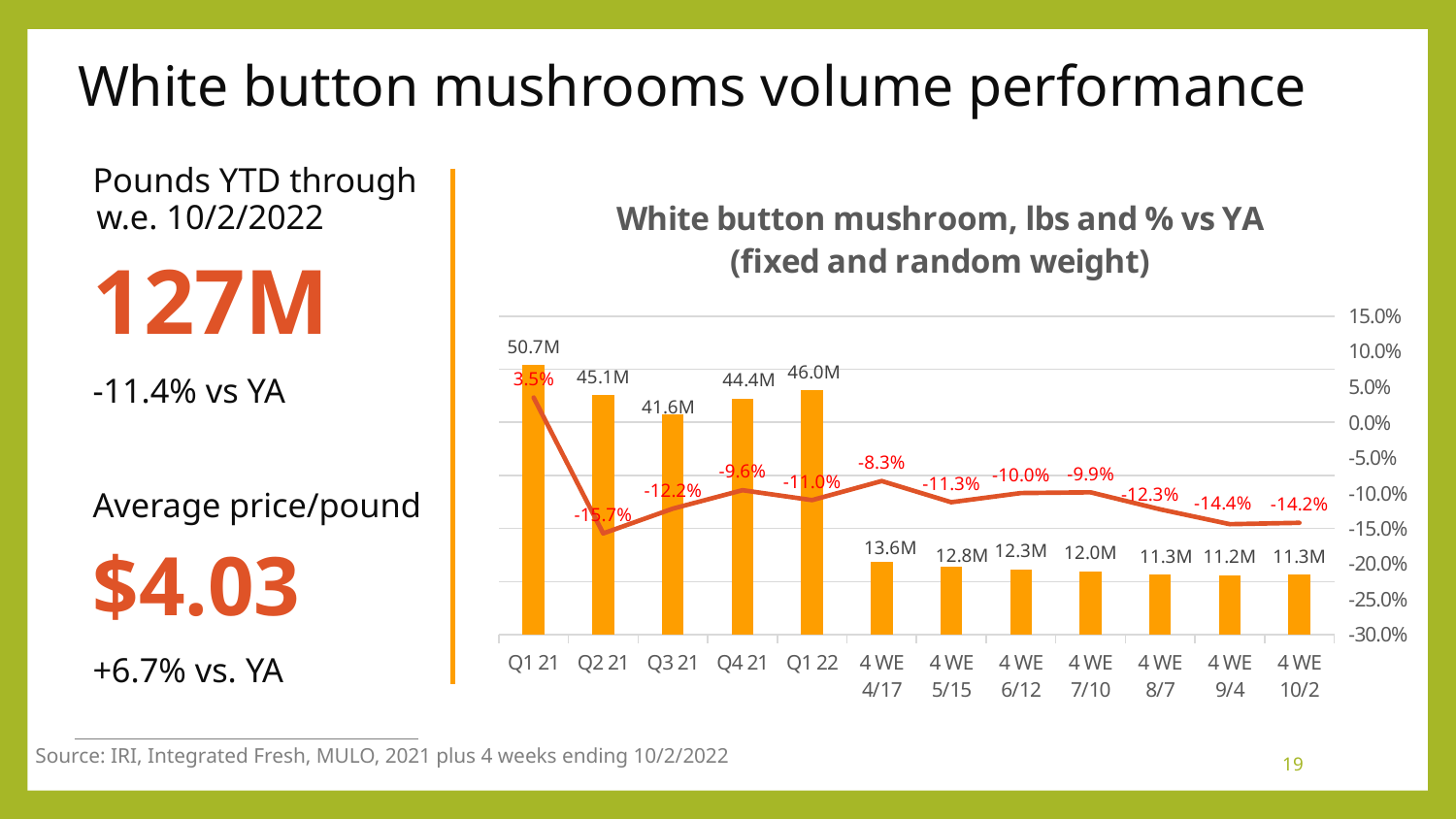
What is the difference in volume between Q1 22 and Q4 21? 1.6M How many periods are shown on the x axis of the chart? 12 What is the volume in pounds shown for Q1 21? 50.7M Which period is the only one with a positive % vs YA value? Q1 21 What kind of chart is shown on the slide? Combination bar and line chart What is the % vs YA value shown for the 4 WE 9/4 period? -14.4% Which period has the lowest % vs YA value on the line? Q2 21 Which period has the highest volume bar? Q1 21 What is the volume in pounds shown for the 4 WE 7/10 period? 12.0M Which has the larger volume, Q2 21 or Q3 21? Q2 21 What is the title of the chart? White button mushroom, lbs and % vs YA (fixed and random weight) Do the volume bars rise or fall from the 4 WE 4/17 period to the 4 WE 8/7 period? Fall